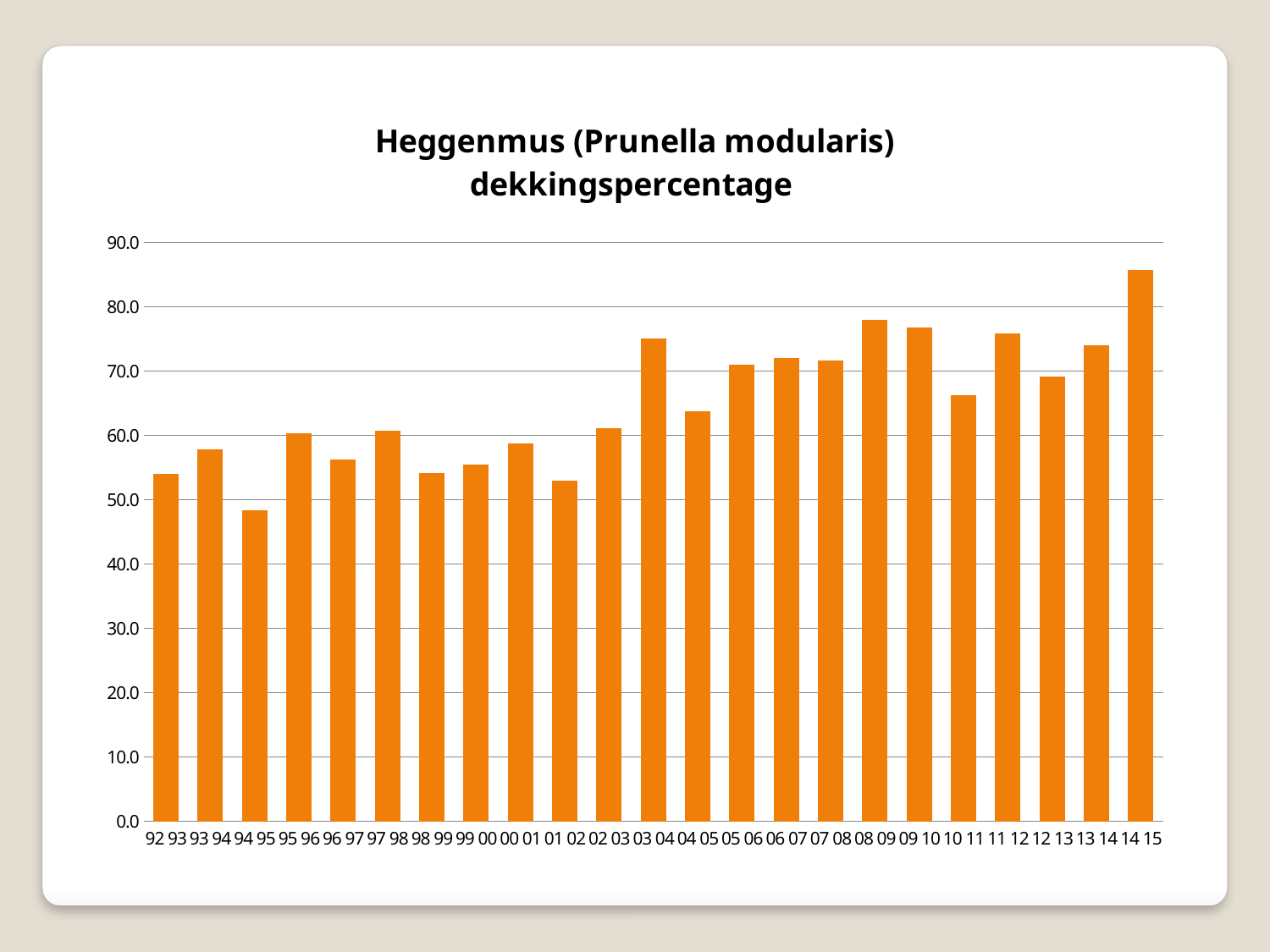
What is the title of the chart? Heggenmus (Prunella modularis) dekkingspercentage Which is larger, the value for 92 93 or the value for 94 95? 92 93 How many bars (seasons) are plotted in the chart? 23 Which season has the lowest dekkingspercentage? 94 95 What kind of chart is shown on the slide? bar chart Is the value for 14 15 greater or less than 80? greater Which is larger, the value for 03 04 or the value for 04 05? 03 04 Do the values generally rise or fall from 92 93 to 14 15? rise Is the value for 03 04 greater or less than 70? greater Which season has the highest dekkingspercentage? 14 15 Is the value for 10 11 greater or less than 70? less